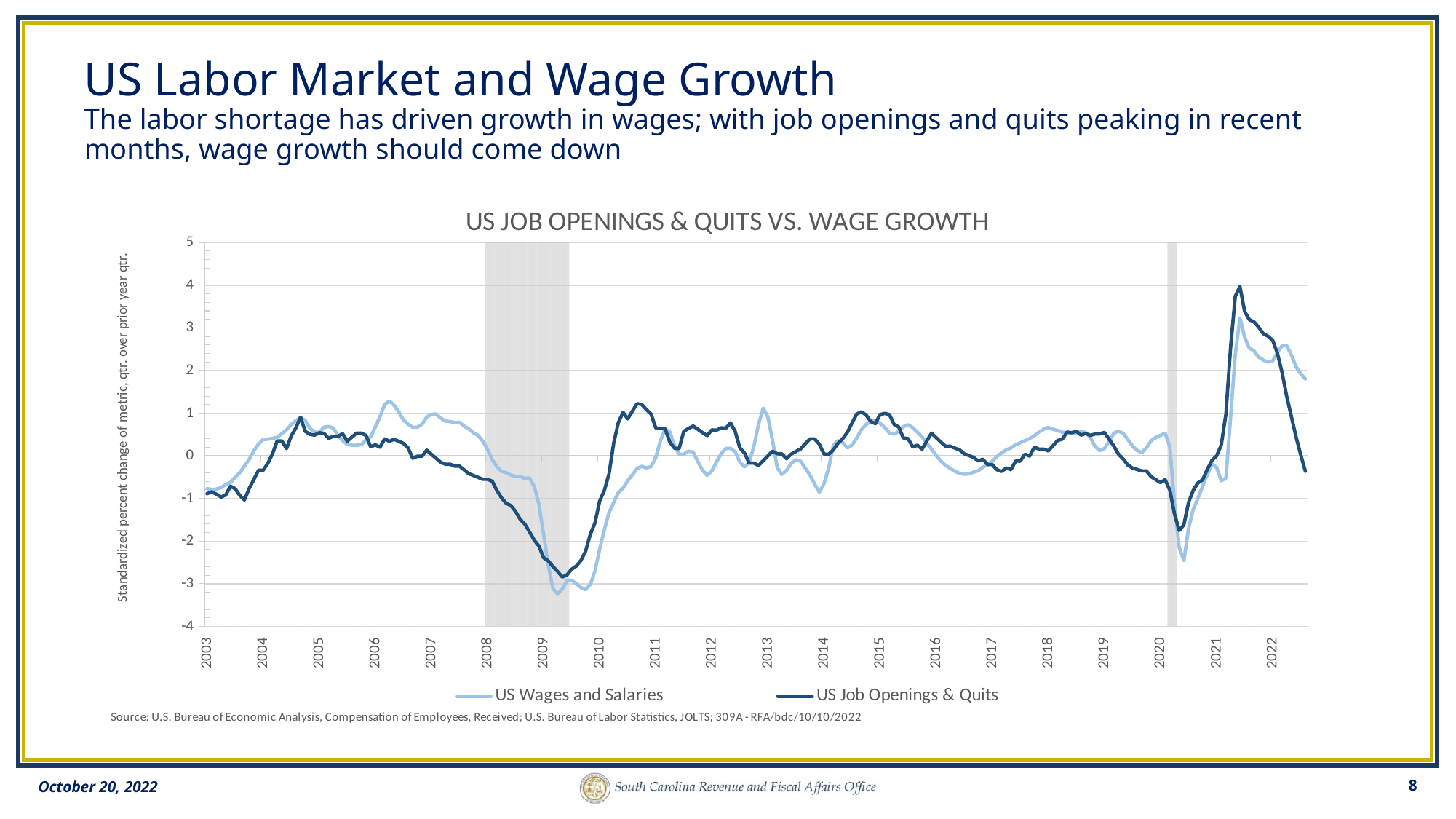
Does the US Job Openings & Quits line rise or fall from its 2021 peak to the end of 2022? Fall How many series does the legend list? 2 Which series is drawn in the darker blue line? US Job Openings & Quits Is the final 2022 value of US Wages and Salaries greater or less than 1? greater Is the lowest value of US Wages and Salaries around 2009 greater or less than -2? less Is the lowest value of US Job Openings & Quits in 2020 greater or less than -1? less What is the title of the chart? US JOB OPENINGS & QUITS VS. WAGE GROWTH Which series fell lower in 2020, US Wages and Salaries or US Job Openings & Quits? US Wages and Salaries Which series reached a higher peak in 2021, US Wages and Salaries or US Job Openings & Quits? US Job Openings & Quits What kind of chart is shown on the slide? Line chart